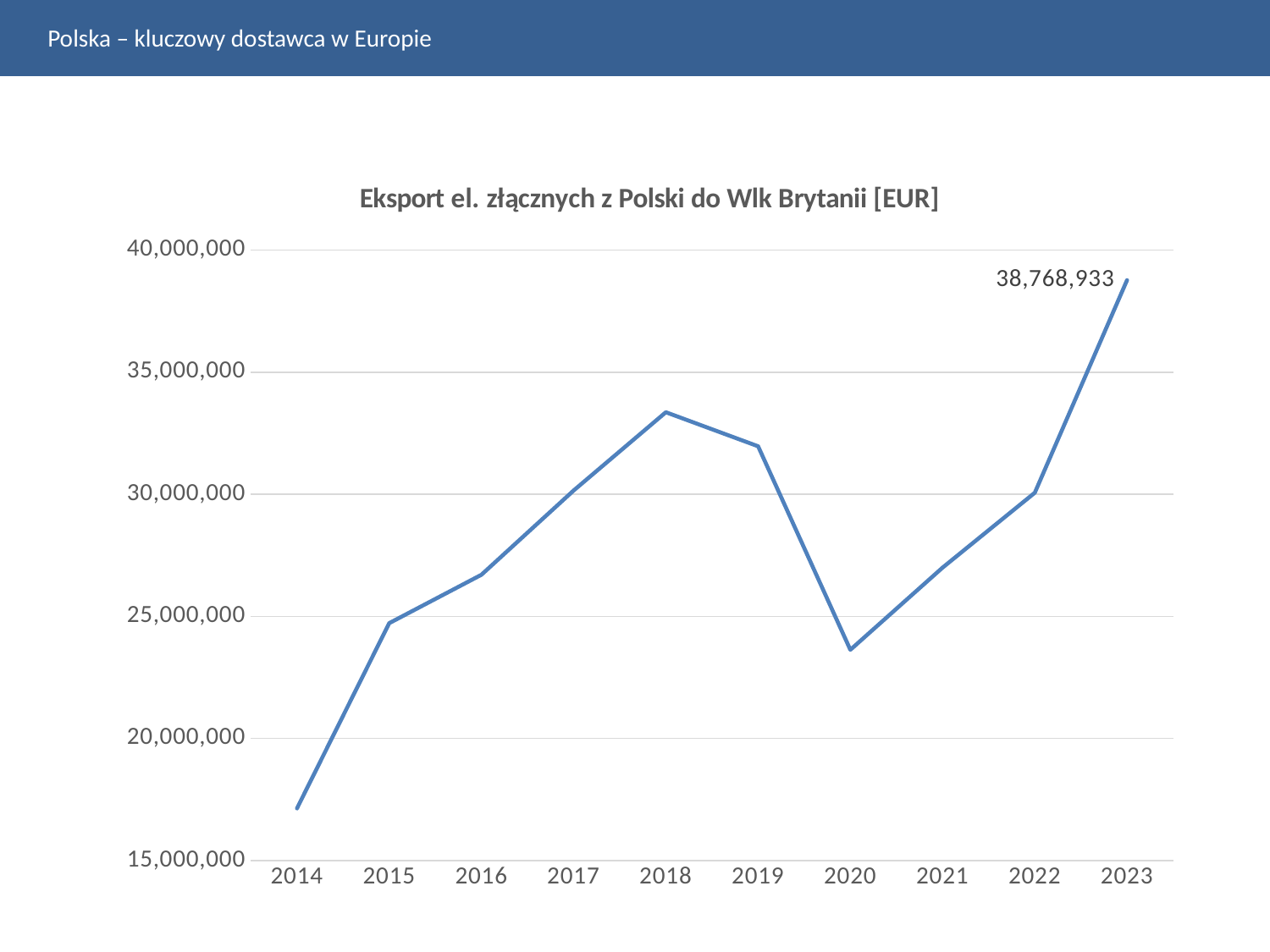
Is the value for 2021 greater or less than 25,000,000? greater Is the value for 2020 greater or less than 25,000,000? less Which is larger, the value for 2015 or the value for 2016? 2016 What is the value for 2023? 38,768,933 What is the title of the chart? Eksport el. złącznych z Polski do Wlk Brytanii [EUR] Is the value for 2018 greater or less than 30,000,000? greater Which is larger, the value for 2018 or the value for 2020? 2018 How many years are shown on the x axis? 10 What kind of chart is this? line chart Which year has the lowest value? 2014 Which year has the highest value? 2023